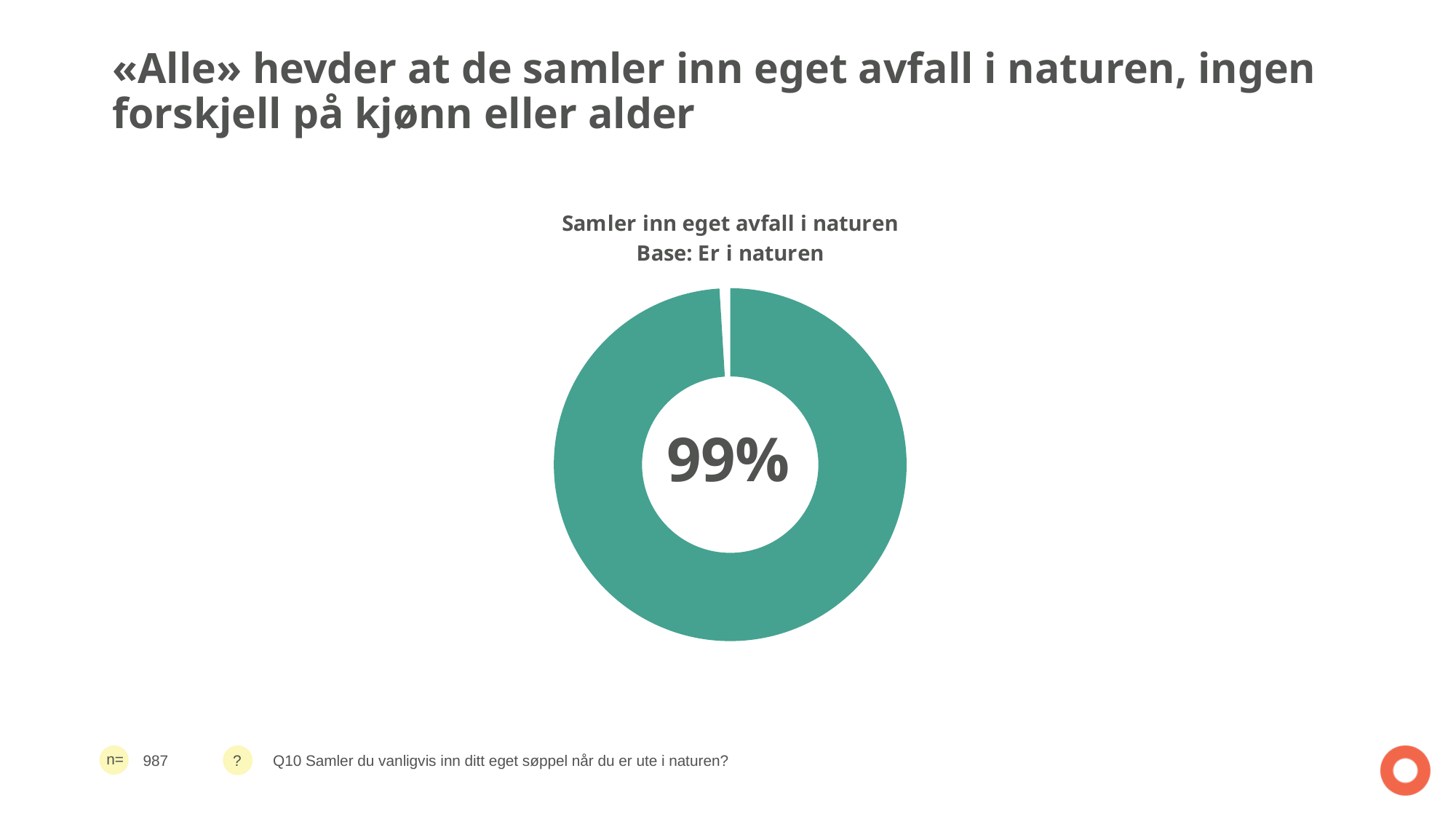
What is the sample size (n) shown on the slide? 987 What share of the pie is not covered by the green slice? 1% What kind of chart is shown on the slide? Pie chart (donut) What base is stated under the chart title? Er i naturen What is the title of the chart? Samler inn eget avfall i naturen What percentage is shown in the centre of the donut chart? 99% How many slices does the donut chart have? 2 What share of the pie does the green slice represent? 99% Is the value shown in the donut chart greater or less than 50%? greater